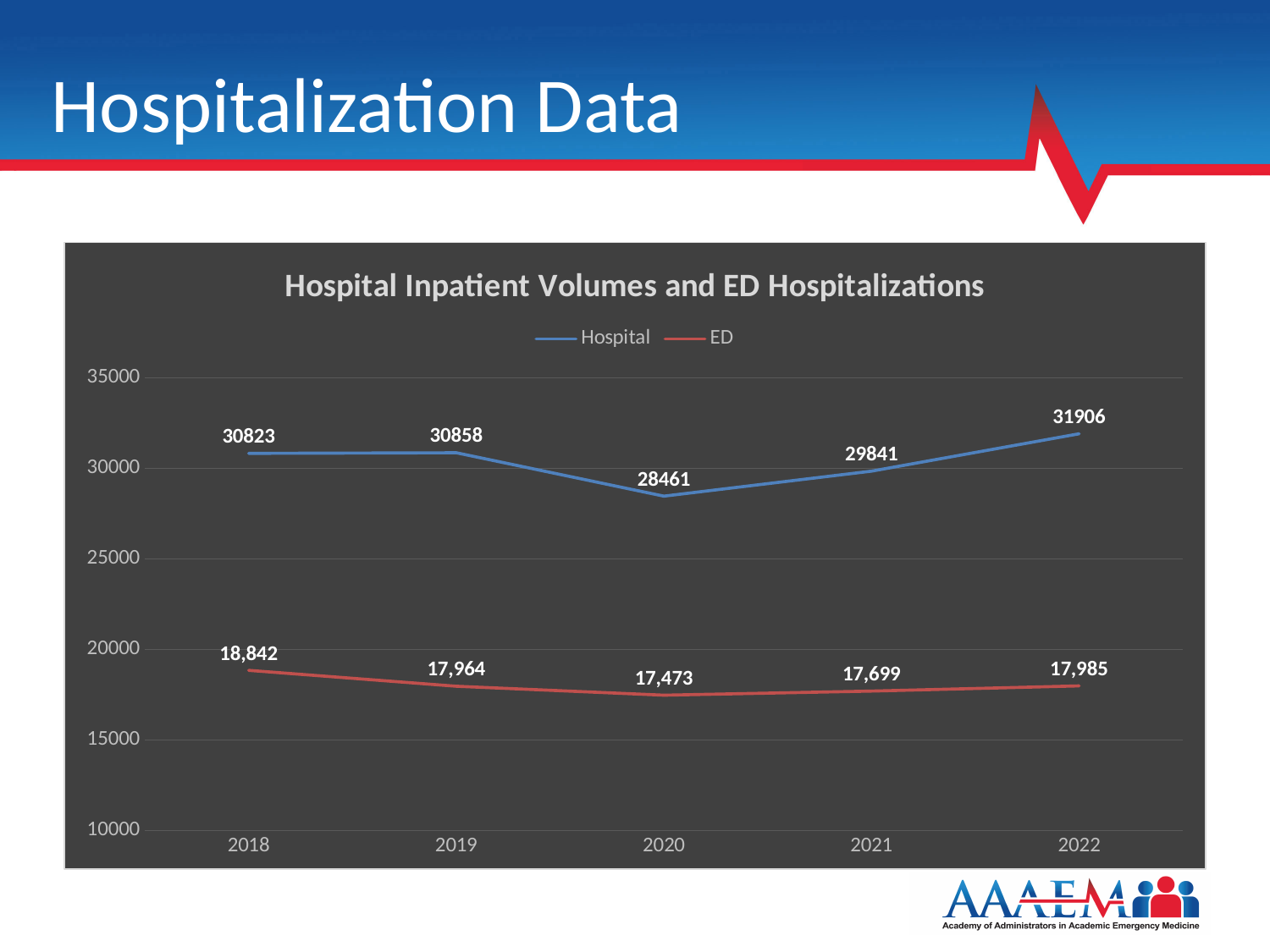
What is the difference between the Hospital value in 2022 and the Hospital value in 2020? 3445 In which year is the ED series lowest? 2020 Is the Hospital value for 2021 greater or less than 30000? less What is the ED value for 2021? 17,699 In which year is the Hospital series highest? 2022 What is the ED value for 2018? 18,842 How many years are shown on the x axis? 5 What is the Hospital value for 2022? 31906 What kind of chart is shown? line chart Which is larger, the ED value for 2019 or the ED value for 2022? 2022 What is the Hospital value for 2020? 28461 How many series does the legend list? 2